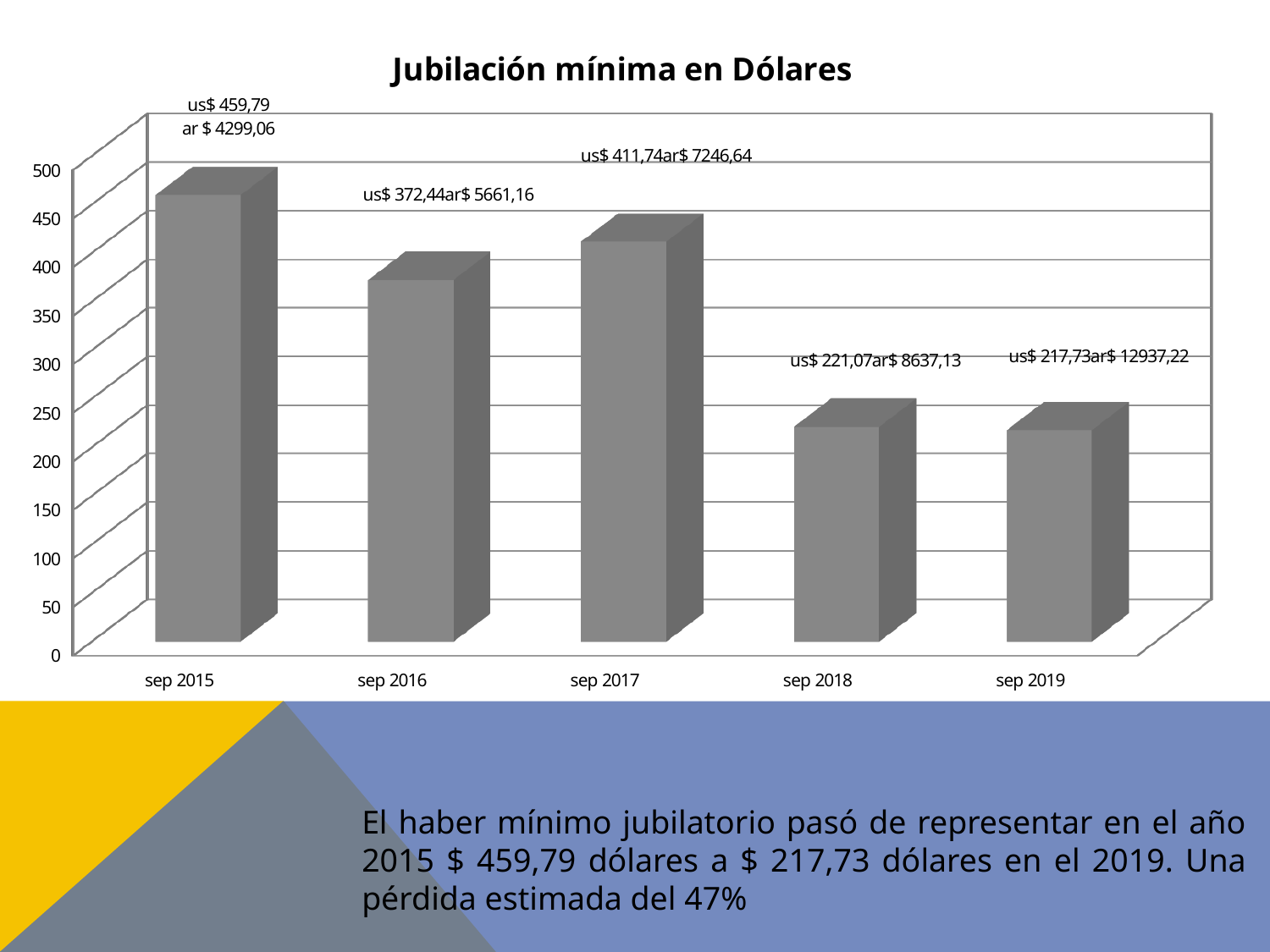
What is the value in US dollars for sep 2018? us$ 221,07 Which year has the highest value in US dollars? sep 2015 What is the value in US dollars for sep 2017? us$ 411,74 What is the difference in US dollars between sep 2015 and sep 2019? 242,06 What is the title of the chart? Jubilación mínima en Dólares Which year has the lowest value in US dollars? sep 2019 How many years are shown on the x axis? 5 Which is larger in US dollars, sep 2016 or sep 2017? sep 2017 What kind of chart is shown? bar chart What is the value in Argentine pesos shown for sep 2019? ar$ 12937,22 What is the value in US dollars for sep 2015? us$ 459,79 Is the value for sep 2018 greater or less than 250? less